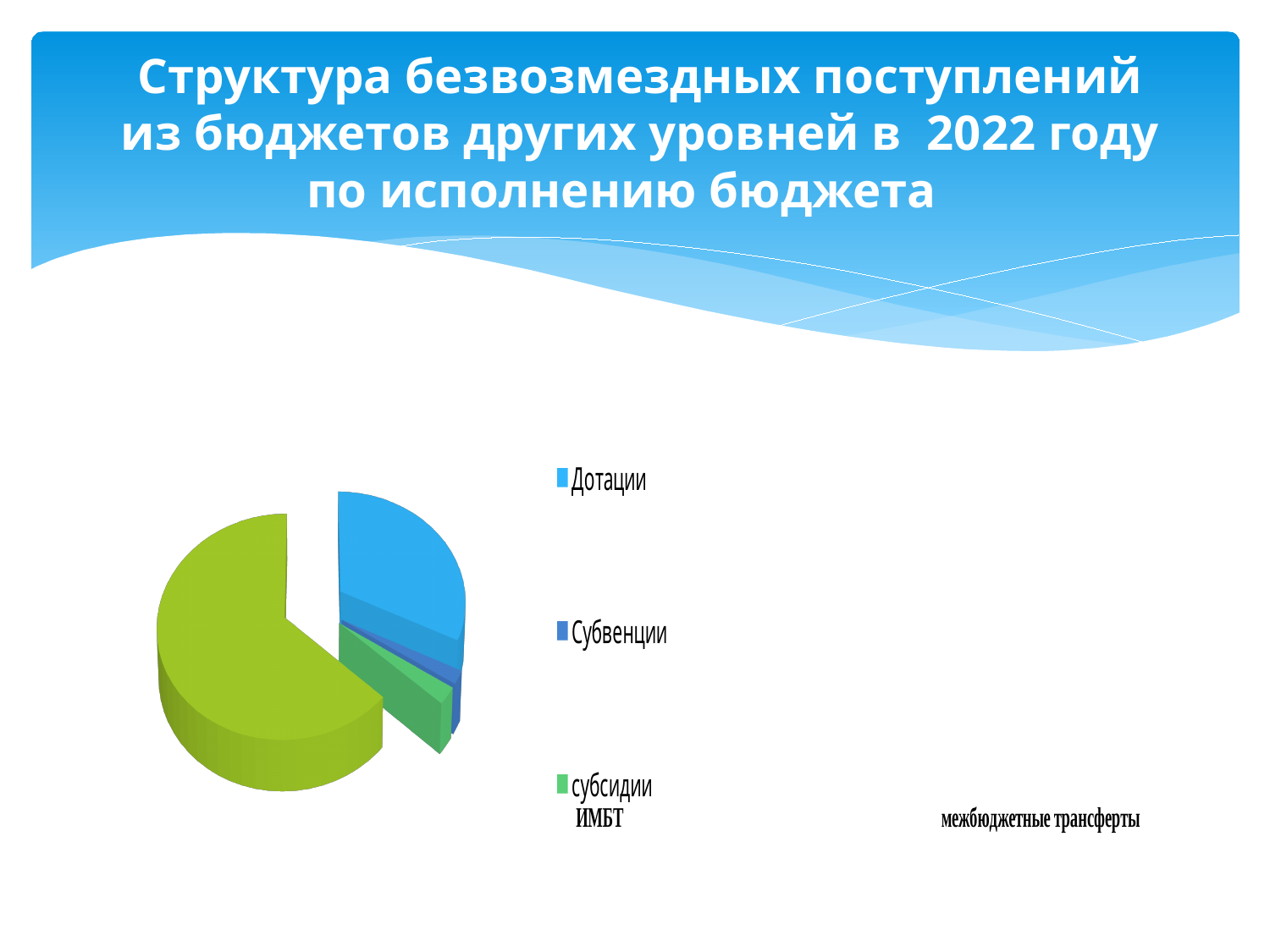
How many slices does the pie chart have? 4 What kind of chart is shown on the slide? pie chart Which of the legend entries Дотации, Субвенции and субсидии has the largest slice? Дотации What colour is the Дотации slice in the pie chart? light blue Which slice is larger, Дотации or Субвенции? Дотации Which slice is larger, Дотации or субсидии? Дотации How many entries with colour markers does the chart legend list? 3 What is the title of the slide containing the pie chart? Структура безвозмездных поступлений из бюджетов других уровней в 2022 году по исполнению бюджета